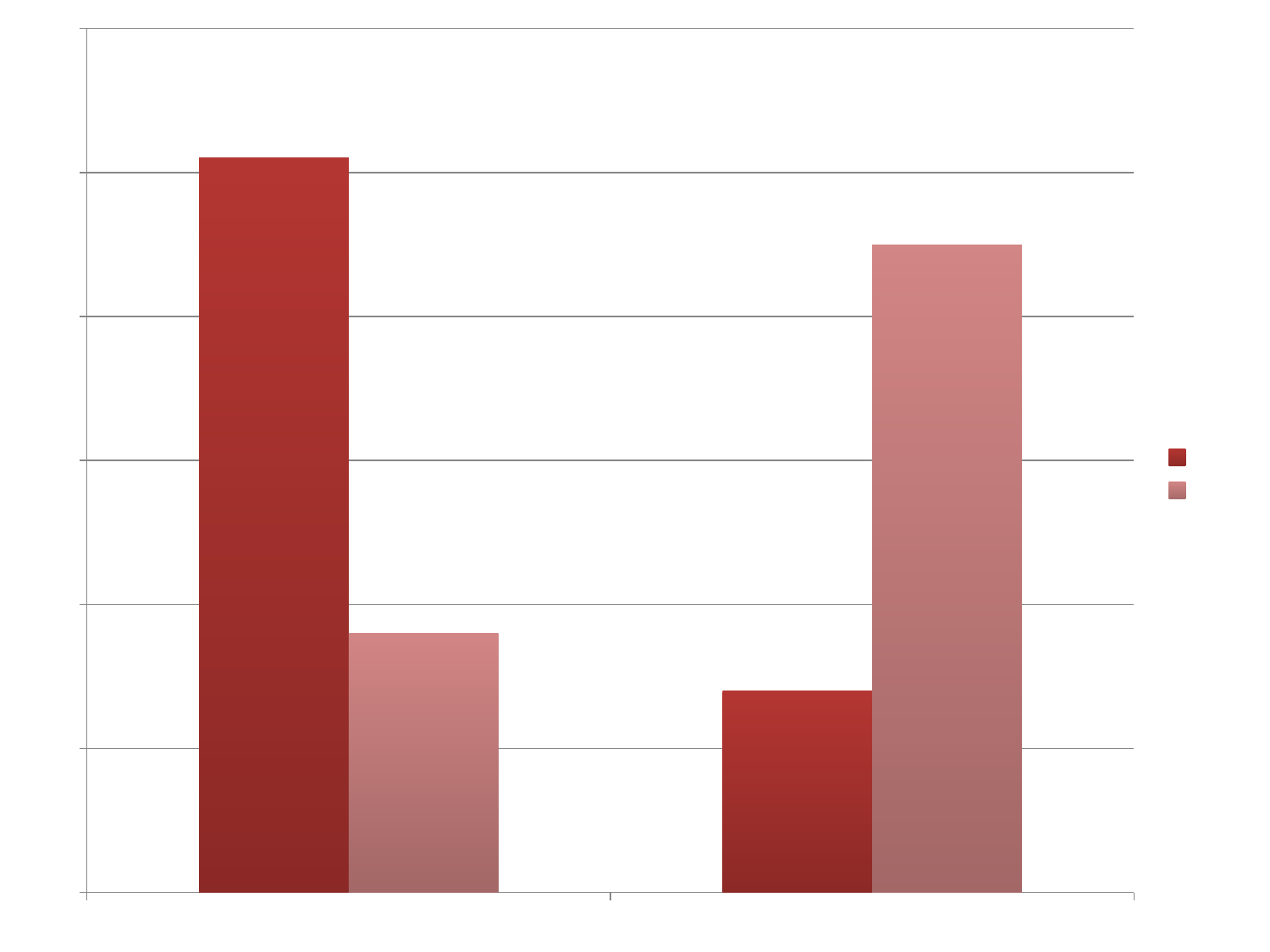
Does the dark red series rise or fall from the left group to the right group? fall How many series does the legend list? 2 How many groups of bars (categories) are plotted on the x axis? 2 In the right group of bars, which bar is taller, the dark red one or the light red one? the light red one How many bars are plotted in total on the chart? 4 In the left group of bars, which bar is taller, the dark red one or the light red one? the dark red one Does the light red series rise or fall from the left group to the right group? rise What kind of chart is shown on the slide? bar chart Where is the legend positioned on the slide? on the right Which bar is the shortest on the chart: the light red bar in the left group or the dark red bar in the right group? the dark red bar in the right group Which bar is the tallest on the chart: the dark red bar in the left group or the light red bar in the right group? the dark red bar in the left group